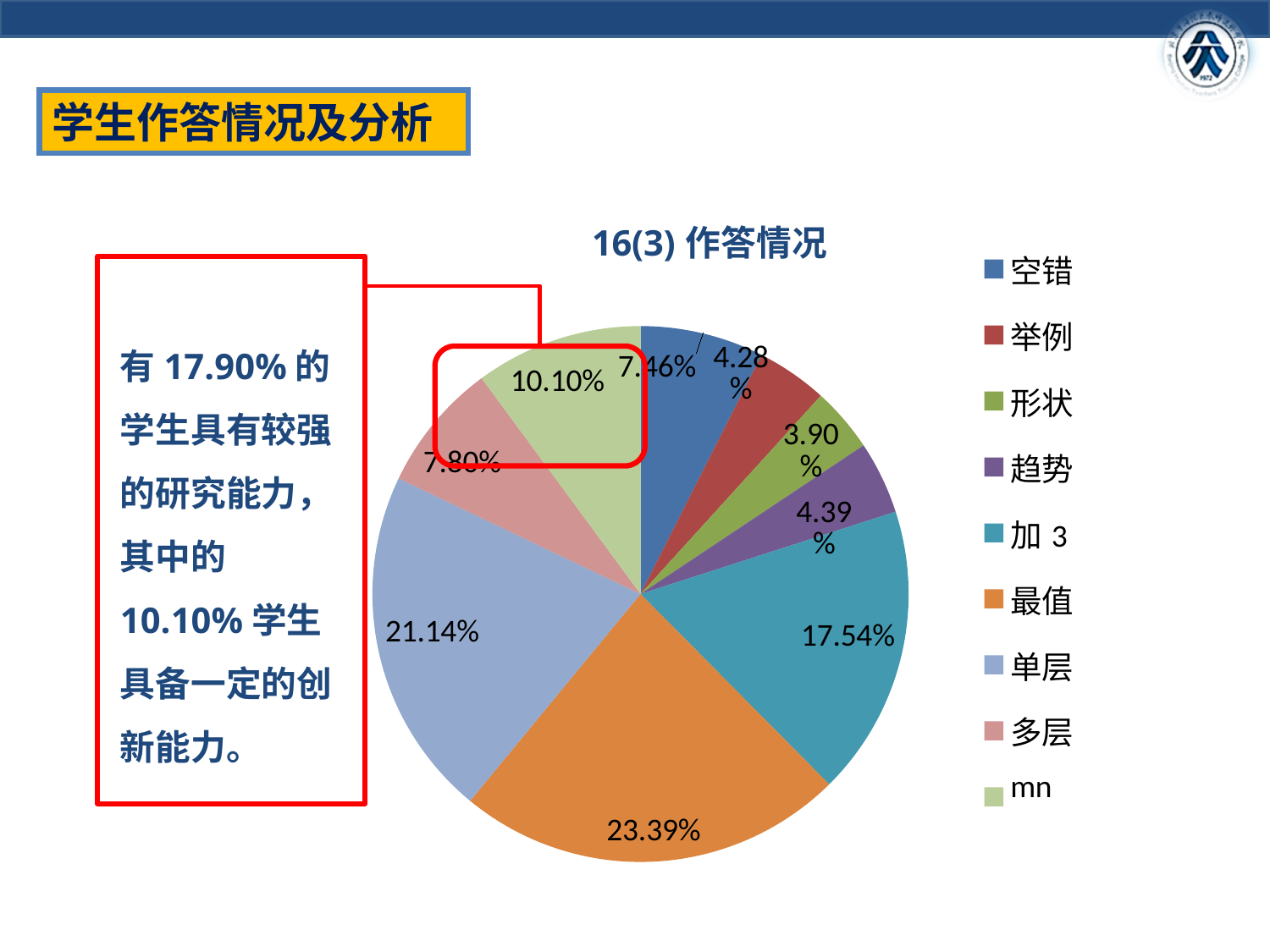
What percentage does the 加 3 slice show? 17.54% What kind of chart is shown on the slide? pie chart What is the title of the chart? 16(3) 作答情况 What is the difference between the 最值 and 单层 percentages? 2.25% What percentage does the mn slice show? 10.10% Which category has the smallest slice of the pie? 形状 Which is larger, the 加 3 slice or the 单层 slice? 单层 How many categories does the legend list? 9 What percentage does the 最值 slice show? 23.39% What percentage does the 单层 slice show? 21.14% Which category has the largest slice of the pie? 最值 What percentage does the 空错 slice show? 7.46%